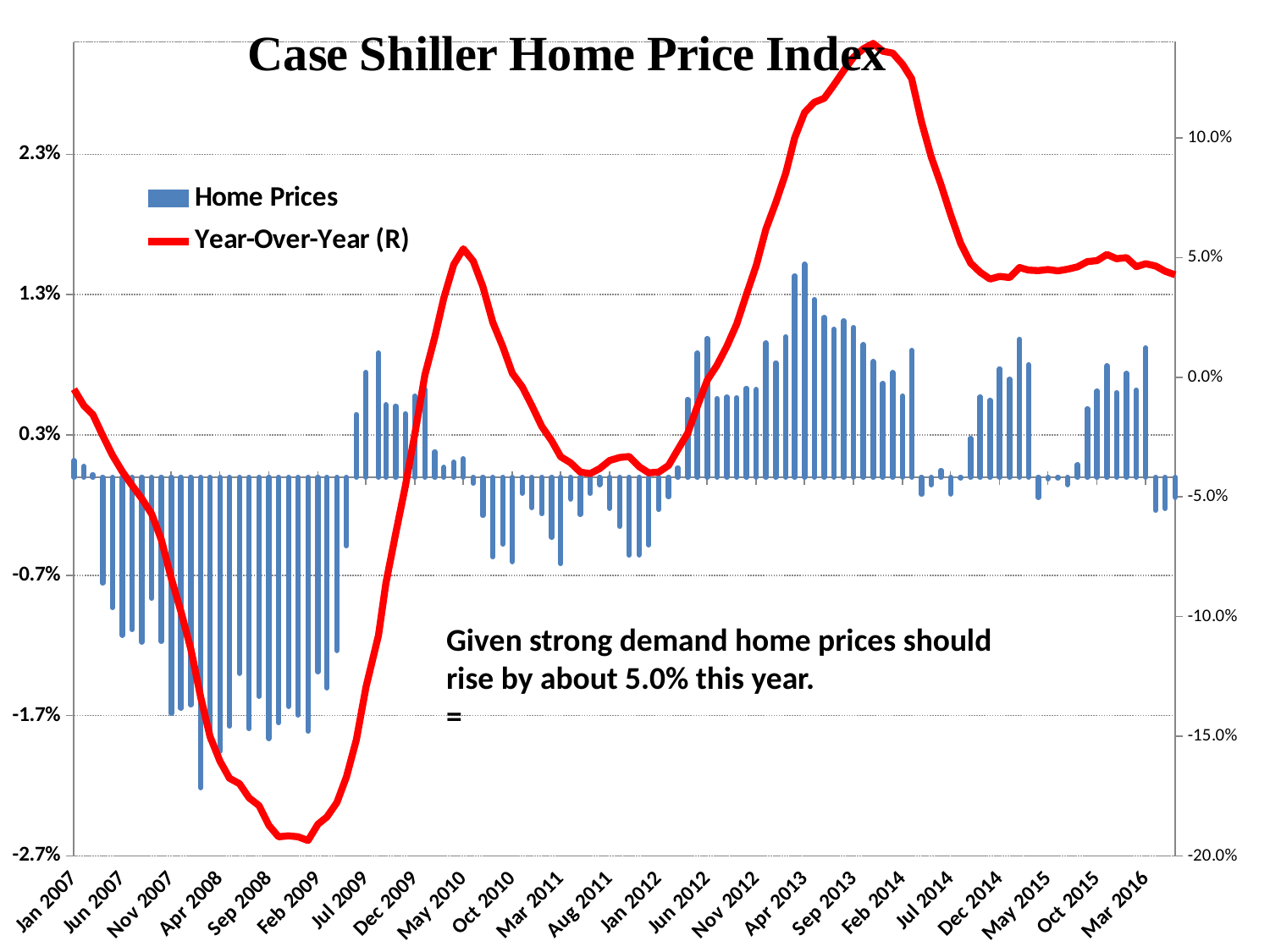
Is the Year-Over-Year (R) value around Feb 2009 greater or less than -15.0%? less Is the Year-Over-Year (R) value at Jan 2007 greater or less than 0.0%? less Is the lowest Home Prices bar, near Apr 2008, greater or less than -1.7%? less Does the Year-Over-Year (R) line rise or fall between Feb 2009 and May 2010? rise Does the Year-Over-Year (R) line rise or fall between Jan 2007 and Feb 2009? fall How many series does the legend list? 2 What are the two series named in the legend? Home Prices; Year-Over-Year (R) What is the title of the chart? Case Shiller Home Price Index What kind of chart is this? Combination bar and line chart Near which labeled month does the Year-Over-Year (R) line reach its lowest point? Feb 2009